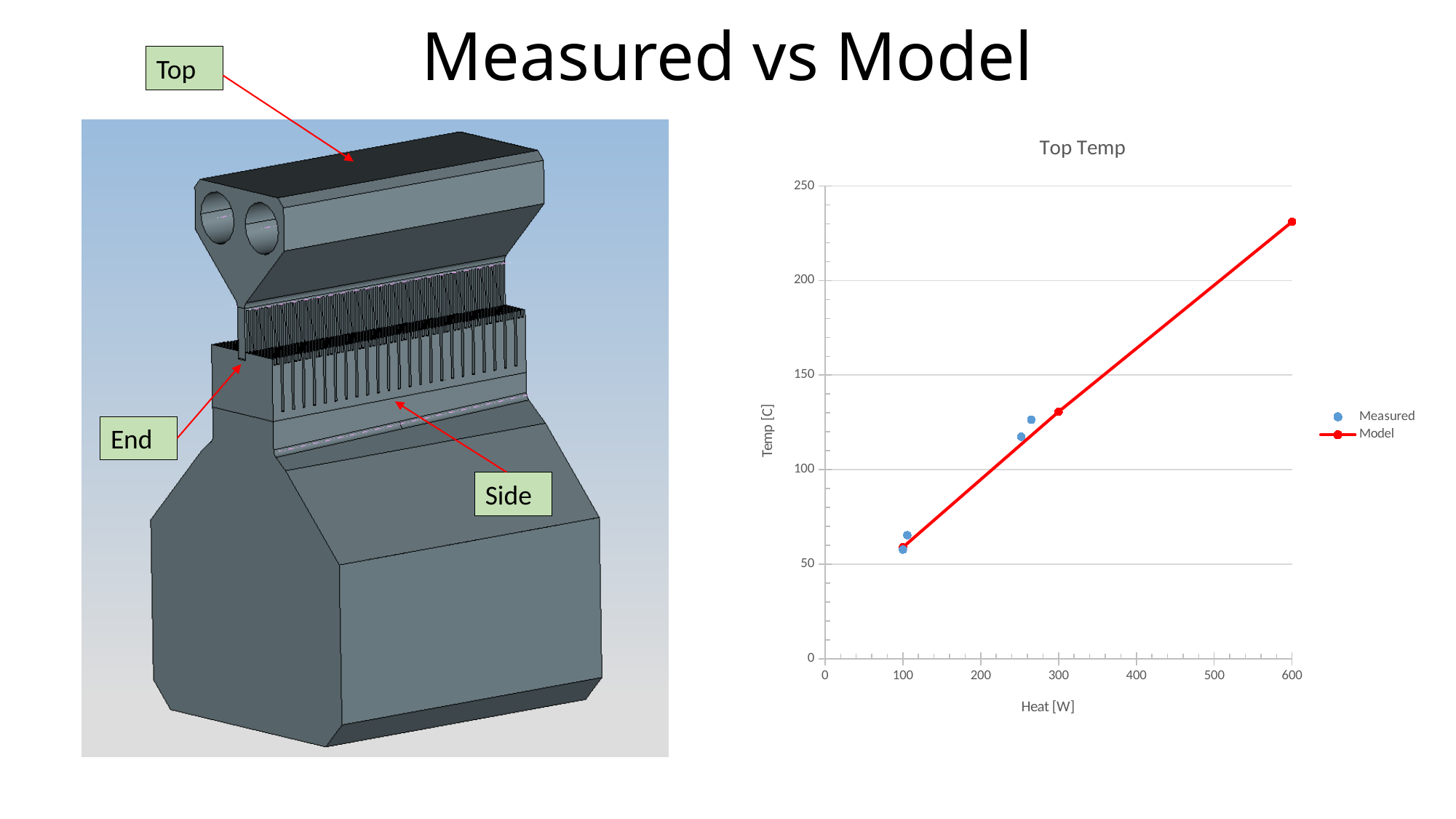
Is the Model value at 600 W greater or less than 200? greater What is the title of the chart? Top Temp What are the two series named in the legend of the Top Temp chart? Measured and Model Does the Model temperature rise or fall as Heat [W] increases? rise Is the Model value at 300 W greater or less than 100? greater Is the Model value at 600 W greater or less than 250? less How many Model points are plotted on the chart? 3 What is the label of the x axis of the chart? Heat [W] How many series does the legend of the Top Temp chart list? 2 Which is larger, the Model value at 600 W or the Model value at 300 W? Model value at 600 W What kind of chart is shown on the slide? scatter chart